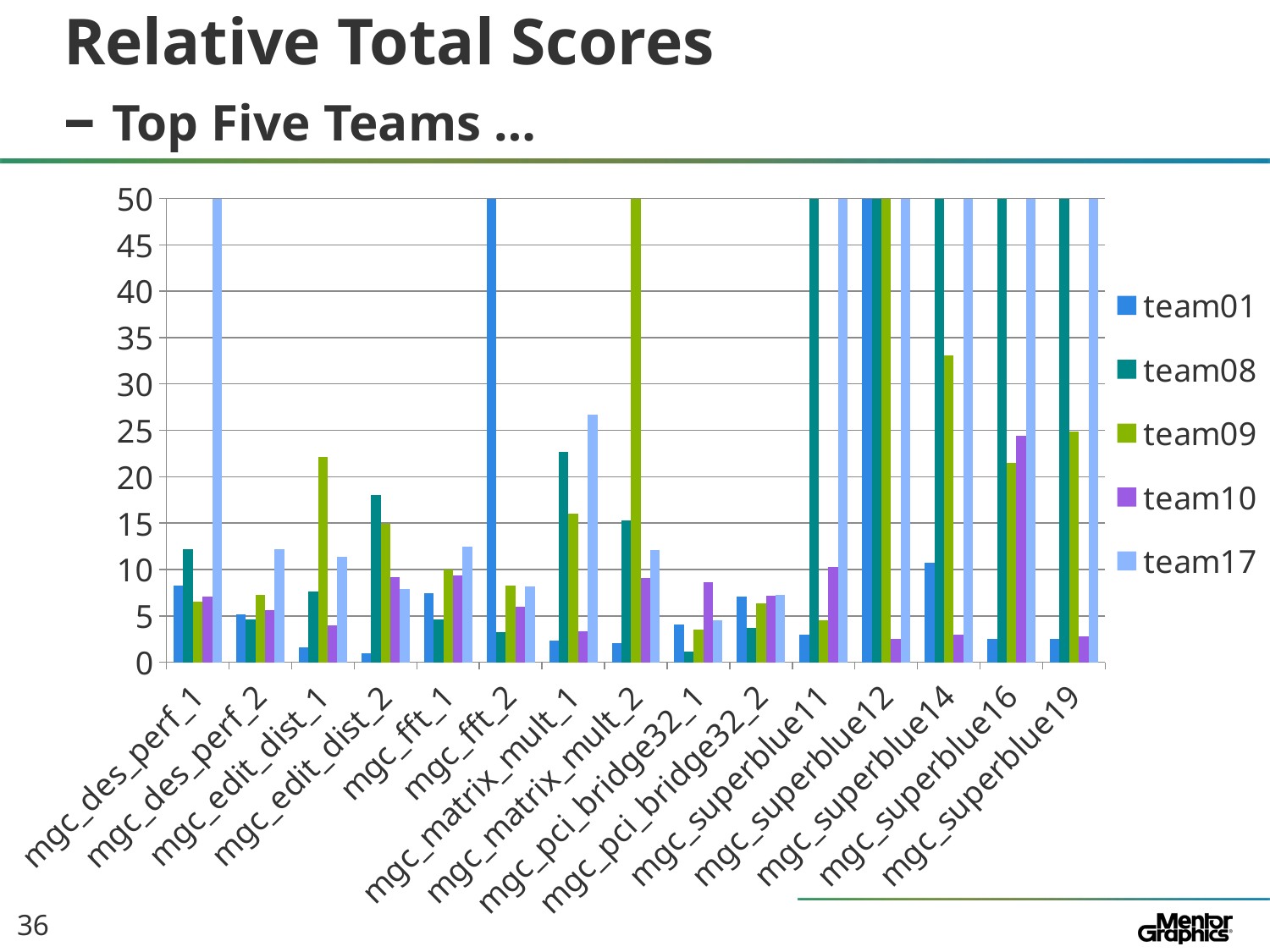
Is the value for team08 at mgc_edit_dist_2 greater or less than 20? less Which team has the highest bar for mgc_fft_2? team01 How many series does the legend list? 5 Which team has the highest bar for mgc_edit_dist_1? team09 For mgc_superblue14, which is larger: team01 or team09? team09 Which team has the lowest bar for mgc_edit_dist_1? team01 How many benchmark categories are shown along the x axis? 15 Is the value for team17 at mgc_matrix_mult_1 greater or less than 25? greater What kind of chart is shown on the slide? bar chart Is the value for team09 at mgc_superblue14 greater or less than 30? greater What is the title of the slide containing the chart? Relative Total Scores – Top Five Teams … For mgc_matrix_mult_2, which is larger: team09 or team10? team09